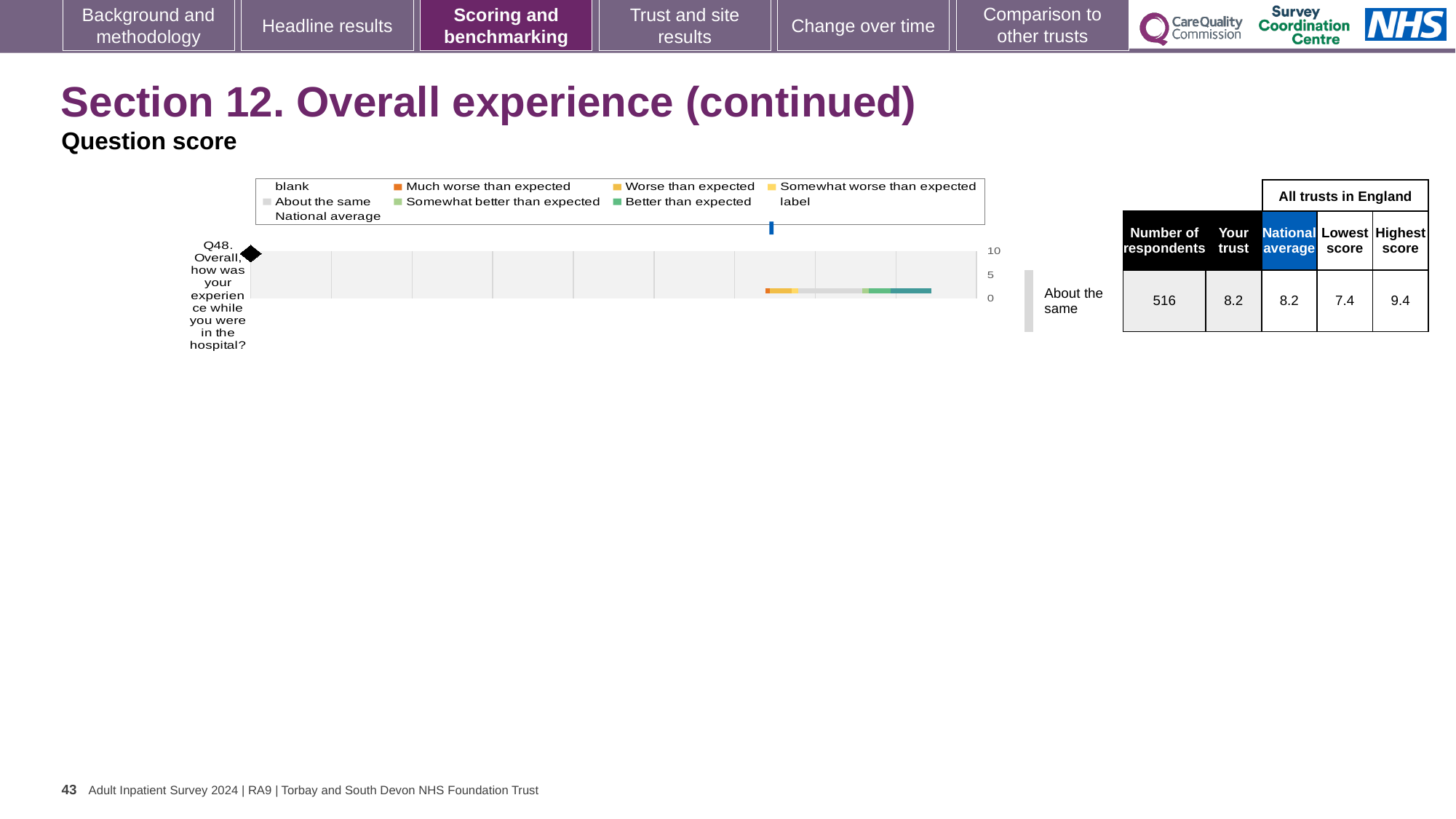
How many survey questions are plotted in the chart? 1 Is the trust's score for Q48 higher than, lower than, or the same as the national average? the same Is the trust's score for Q48 greater or less than 5 on the chart's axis? greater Which survey question is plotted in the chart? Q48. Overall, how was your experience while you were in the hospital? What is the 'Your trust' score for Q48? 8.2 What benchmark category is shown next to the chart for Q48? About the same What kind of chart is shown on the slide? bar chart What is the highest score among all trusts in England for Q48? 9.4 What is the number of respondents for Q48? 516 What is the national average score for Q48? 8.2 What is the difference between the highest and lowest scores among all trusts in England for Q48? 2.0 What is the lowest score among all trusts in England for Q48? 7.4